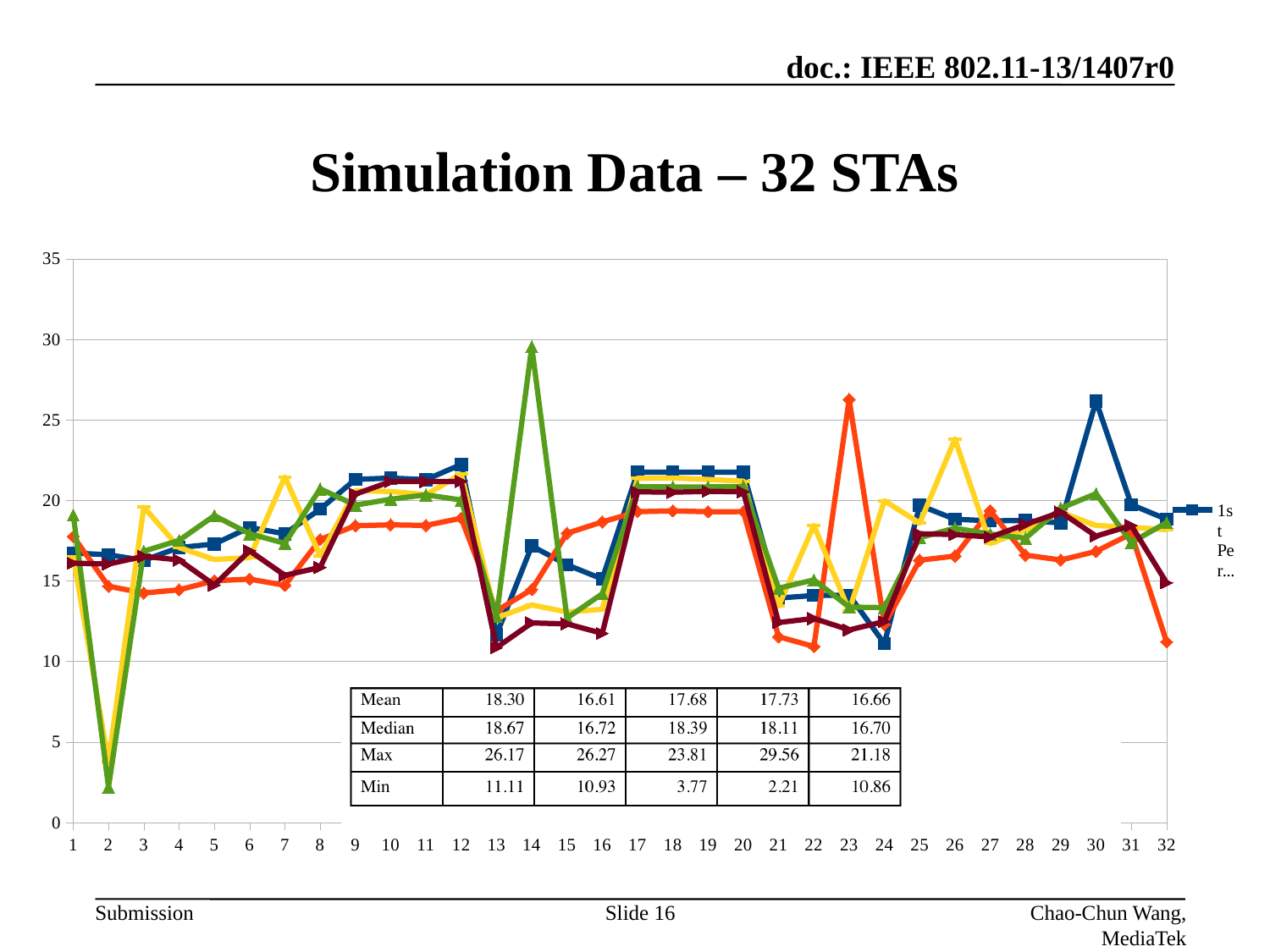
How many points are there along the x axis of the chart? 32 In the table on the chart, what is the Mean value in the first numeric column? 18.30 In the table on the chart, what is the smallest value in the Min row? 2.21 Is the value of the green line at x = 2 greater or less than 5? less Is the value of the blue line at x = 30 greater or less than 25? greater Is the value of the green line at x = 14 greater or less than 25? greater What is the title of the slide's chart? Simulation Data – 32 STAs How many lines are plotted on the chart? 5 What kind of chart is shown on the slide? line chart In the table on the chart, what is the largest value in the Max row? 29.56